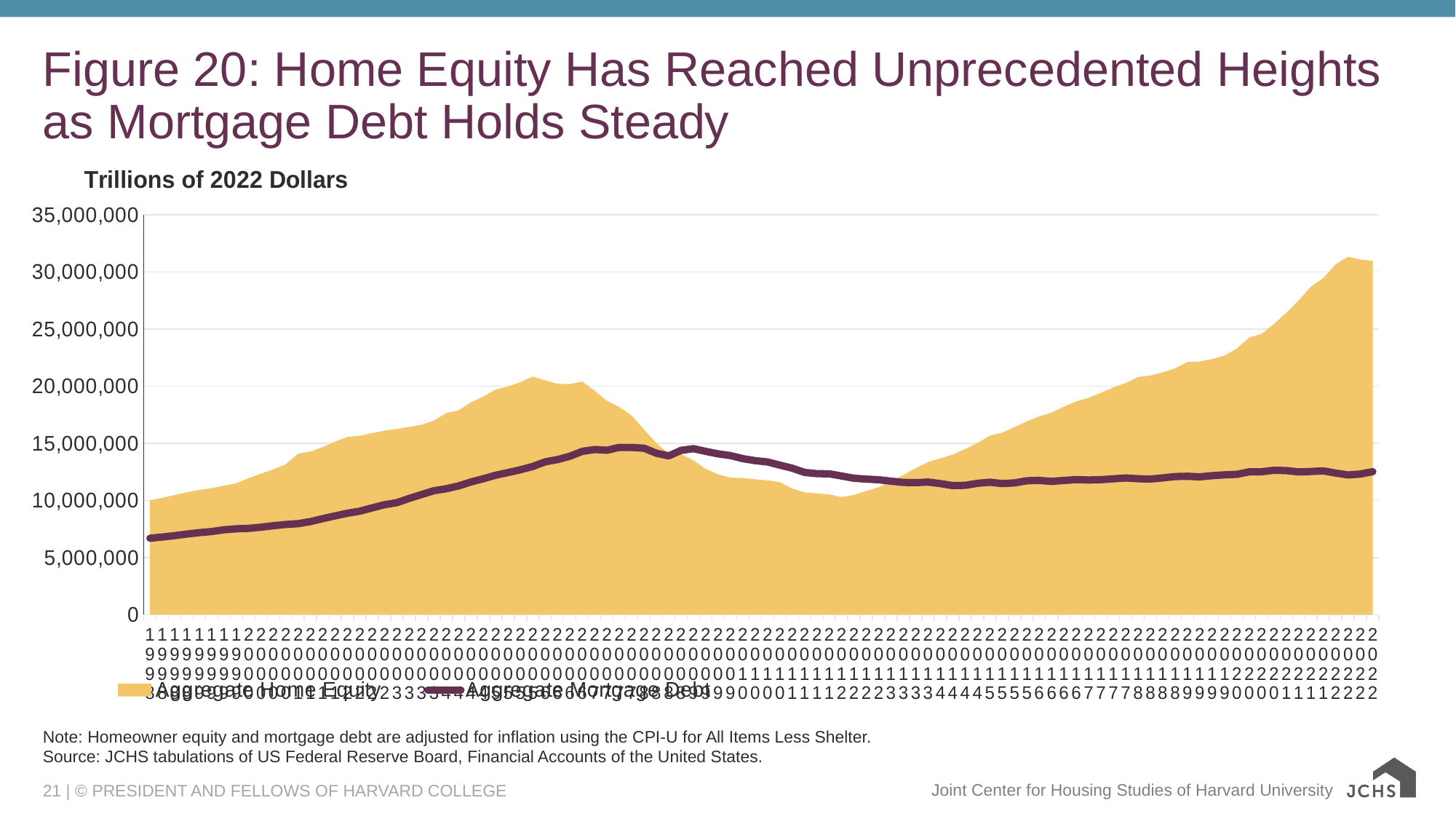
Which series reaches the highest value on the chart? Aggregate Home Equity At the right end of the chart, which is larger: Aggregate Home Equity or Aggregate Mortgage Debt? Aggregate Home Equity Overall, does Aggregate Home Equity rise or fall from the left end to the right end of the chart? rise What is the unit label shown above the chart? Trillions of 2022 Dollars How many series does the legend list? 2 Is the peak value of Aggregate Home Equity greater or less than 30,000,000? greater What kind of chart is shown on the slide? Area chart with a line Is the lowest point of Aggregate Home Equity in the middle of the chart greater or less than 15,000,000? less Is the value of Aggregate Mortgage Debt at the right end of the chart greater or less than 15,000,000? less What are the two series named in the legend? Aggregate Home Equity and Aggregate Mortgage Debt